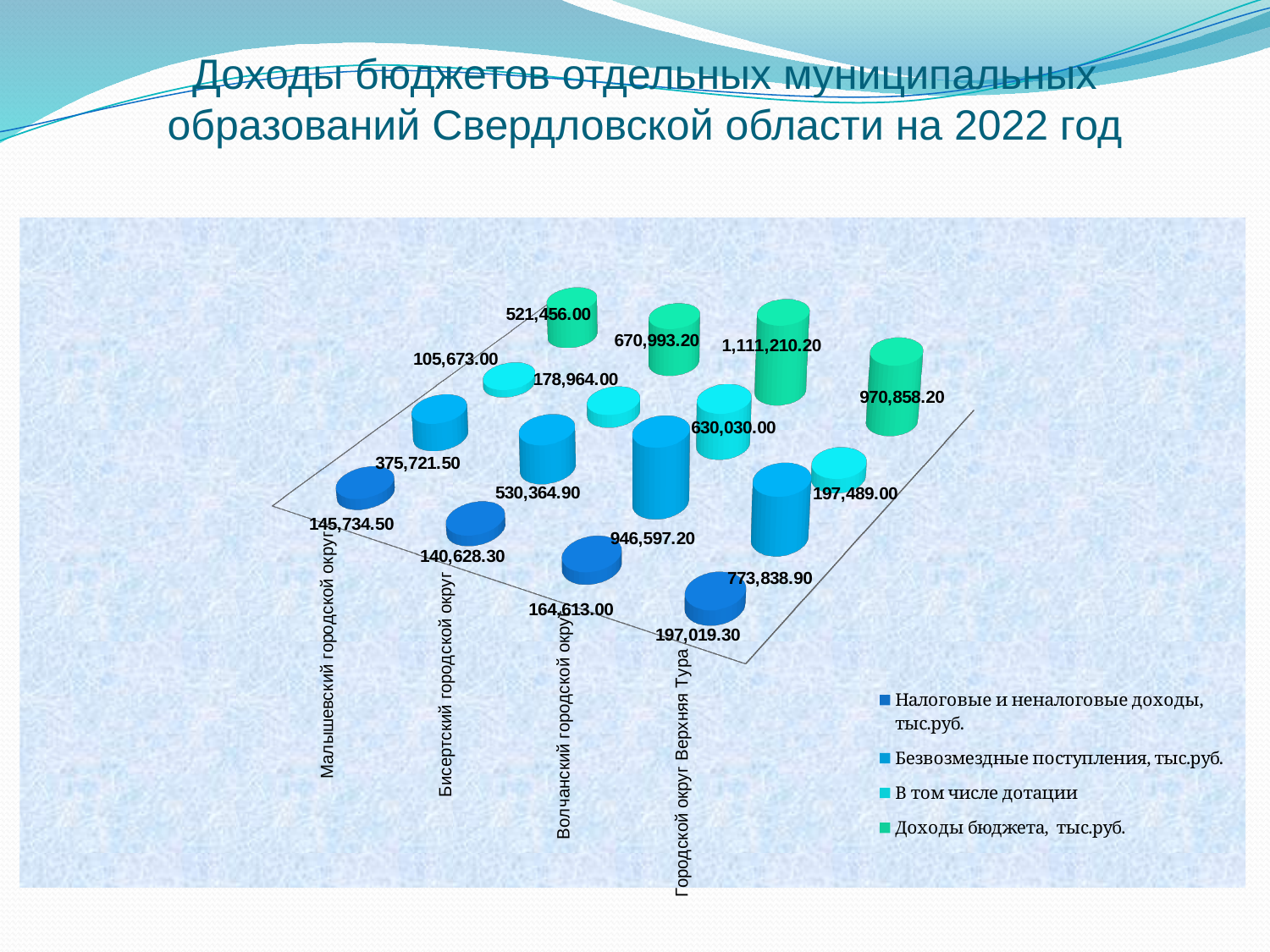
What is the difference between Доходы бюджета, тыс.руб. for Волчанский городской округ and for Городской округ Верхняя Тура? 140,352.00 Which is larger: Безвозмездные поступления, тыс.руб. for Волчанский городской округ or for Городской округ Верхняя Тура? Волчанский городской округ What is the value of Налоговые и неналоговые доходы, тыс.руб. for Малышевский городской округ? 145,734.50 How many municipalities are shown on the chart? 4 Which municipality has the highest value of Доходы бюджета, тыс.руб.? Волчанский городской округ What kind of chart is shown on the slide? 3D bar chart What is the value of В том числе дотации for Городской округ Верхняя Тура? 197,489.00 Which municipality has the lowest value of Налоговые и неналоговые доходы, тыс.руб.? Бисертский городской округ How many series does the legend list? 4 What is the value of Доходы бюджета, тыс.руб. for Волчанский городской округ? 1,111,210.20 Which series is shown in green in the legend? Доходы бюджета, тыс.руб. What is the value of Безвозмездные поступления, тыс.руб. for Бисертский городской округ? 530,364.90